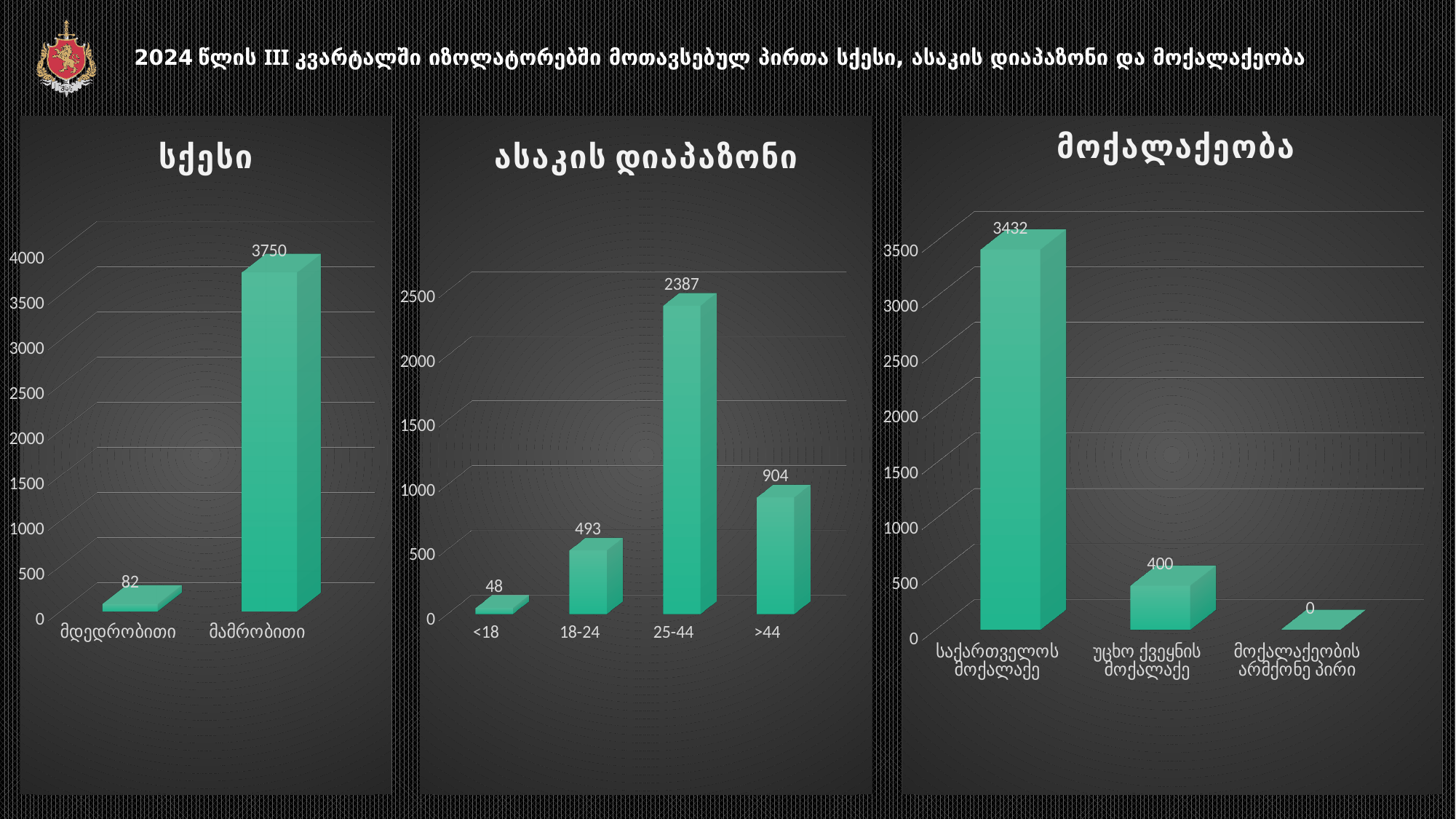
In the left chart titled სქესი, what is the value for მდედრობითი? 82 In the middle chart titled ასაკის დიაპაზონი, what is the difference between the values for >44 and 18-24? 411 In the middle chart titled ასაკის დიაპაზონი, what is the value for the 25-44 age group? 2387 In the middle chart titled ასაკის დიაპაზონი, how many age groups are shown? 4 In the right chart titled მოქალაქეობა, which category has the highest value? საქართველოს მოქალაქე In the right chart titled მოქალაქეობა, what is the value for საქართველოს მოქალაქე? 3432 In the right chart titled მოქალაქეობა, what is the value for მოქალაქეობის არმქონე პირი? 0 In the left chart titled სქესი, what is the difference between the values for მამრობითი and მდედრობითი? 3668 In the left chart titled სქესი, what is the value for მამრობითი? 3750 In the middle chart titled ასაკის დიაპაზონი, which is larger, the value for 18-24 or the value for >44? >44 In the middle chart titled ასაკის დიაპაზონი, which age group has the lowest value? <18 What kind of chart is the right chart titled მოქალაქეობა? Bar chart